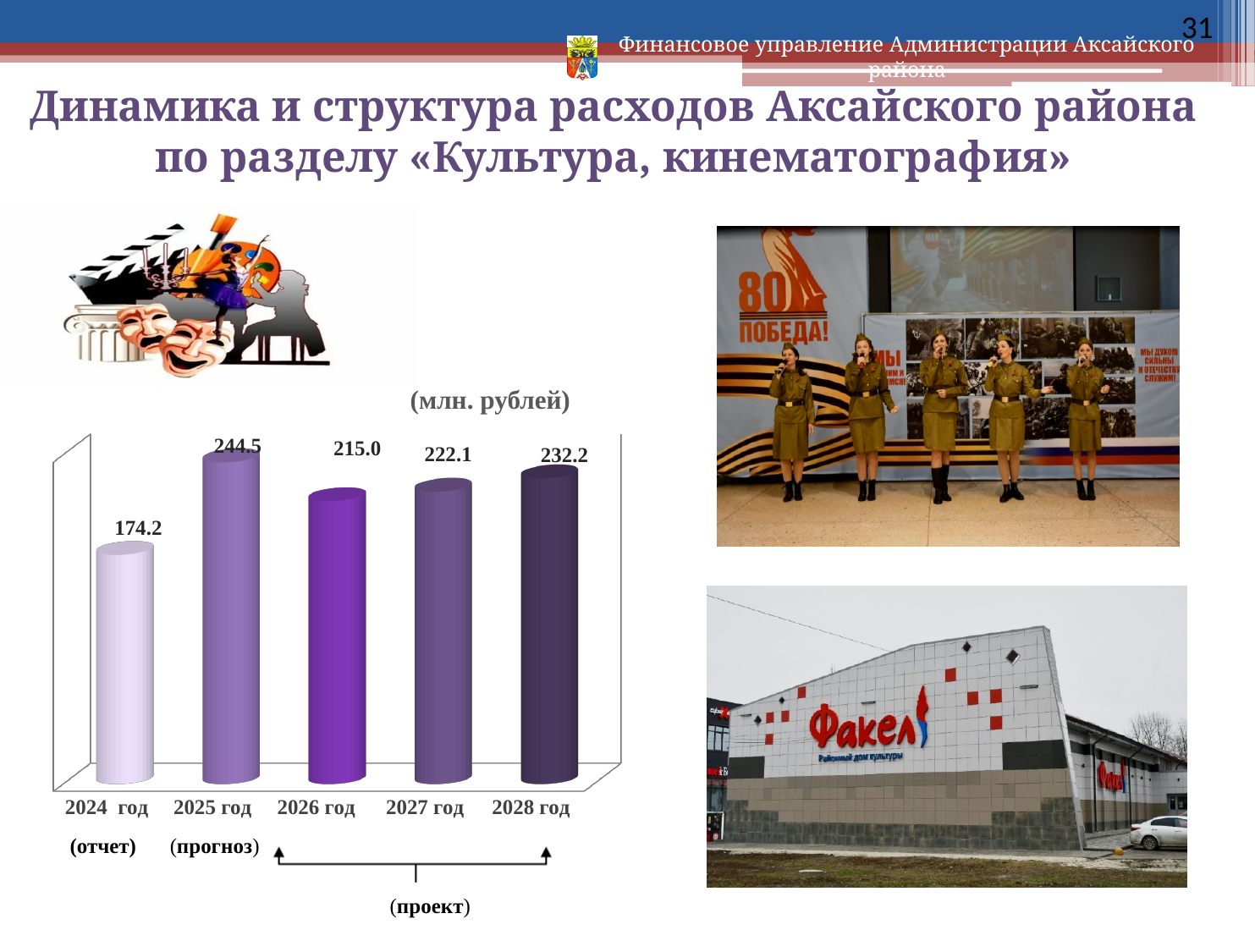
Which is larger, the value for 2026 год or the value for 2027 год? 2027 год What is the value for 2024 год? 174.2 What is the difference between the values for 2028 год and 2027 год? 10.1 Which year has the highest value? 2025 год What is the value for 2026 год? 215.0 What kind of chart is shown on the slide? bar chart In what units are the values on the chart given? млн. рублей What is the value for 2028 год? 232.2 How many years are shown on the chart? 5 What is the difference between the values for 2025 год and 2024 год? 70.3 What is the value for 2025 год? 244.5 Which year has the lowest value? 2024 год